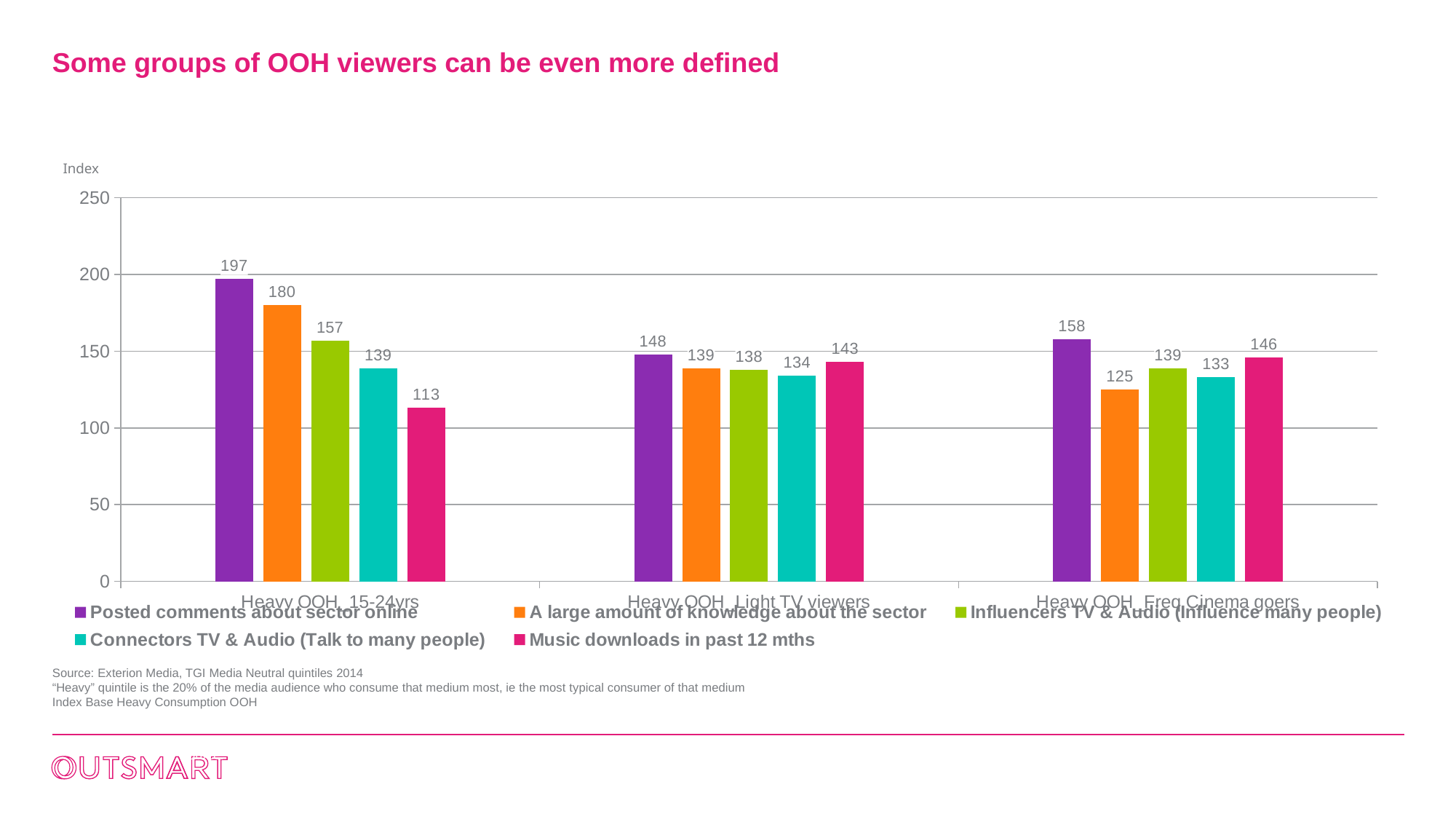
What is the index value for 'A large amount of knowledge about the sector' in the Heavy OOH, Freq Cinema goers group? 125 Which is larger: 'Influencers TV & Audio' for Heavy OOH, 15-24yrs or 'Influencers TV & Audio' for Heavy OOH, Freq Cinema goers? Heavy OOH, 15-24yrs Which series has the highest index value in the Heavy OOH, 15-24yrs group? Posted comments about sector online What is the difference between the 'Posted comments about sector online' value and the 'Music downloads in past 12 mths' value in the Heavy OOH, 15-24yrs group? 84 What is the index value for 'Music downloads in past 12 mths' in the Heavy OOH, Light TV viewers group? 143 Is the value for 'Connectors TV & Audio' in the Heavy OOH, Light TV viewers group greater or less than 150? less Which series has the lowest index value in the Heavy OOH, Freq Cinema goers group? A large amount of knowledge about the sector What kind of chart is shown on the slide? bar chart How many audience groups are shown on the x axis? 3 What is the index value for 'Posted comments about sector online' in the Heavy OOH, 15-24yrs group? 197 How many series does the legend list? 5 What is the label on the vertical axis of the chart? Index